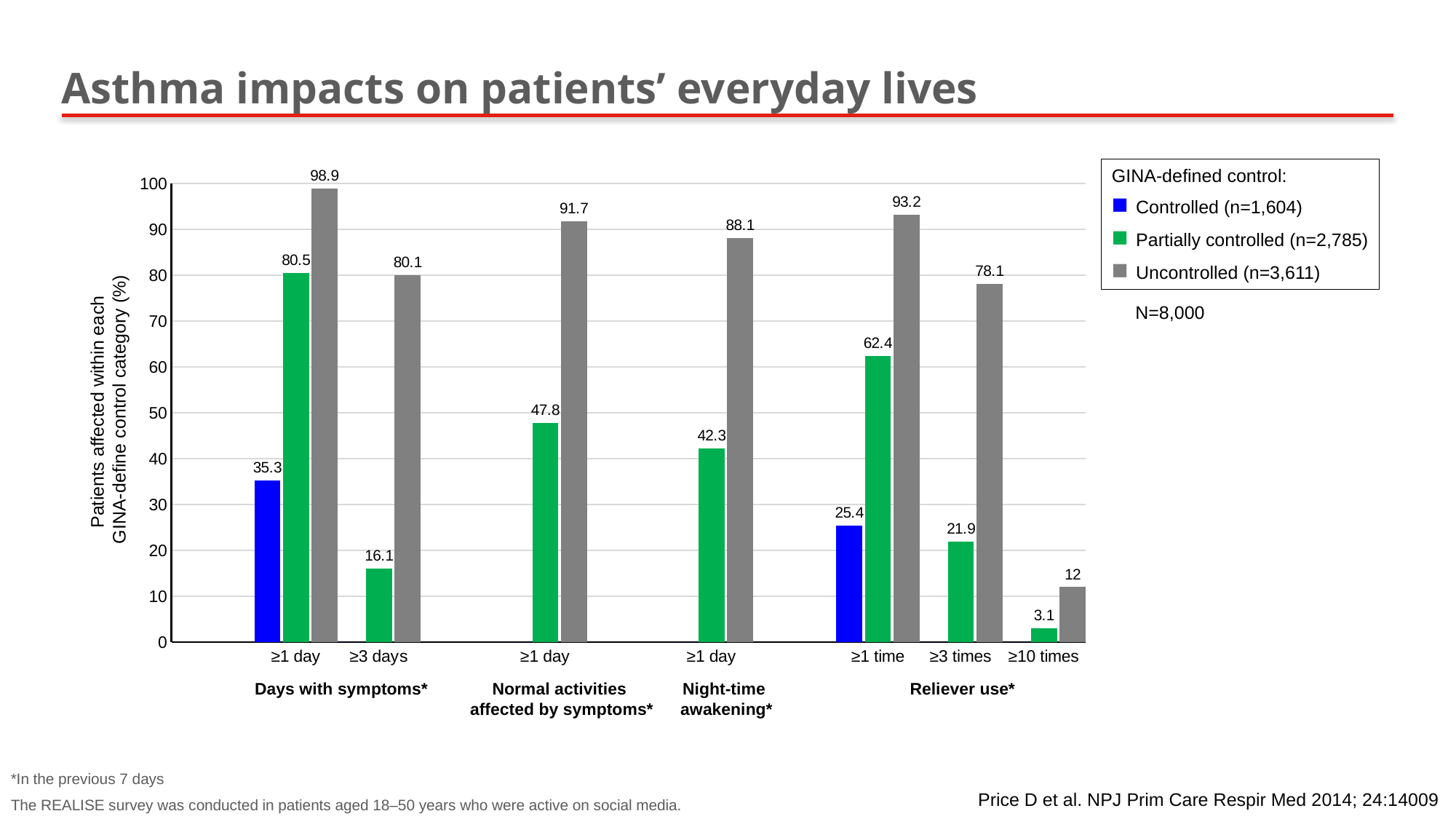
What is the value for Partially controlled patients with ≥1 time of reliever use? 62.4 Which category has the highest value for the Uncontrolled series? ≥1 day (Days with symptoms) What is the value for Uncontrolled patients with ≥1 day of symptoms (Days with symptoms)? 98.9 Which category has the lowest value for the Partially controlled series? ≥10 times (Reliever use) How many series does the legend list? 3 How many categories are shown along the x axis? 7 What is the total N stated next to the legend? N=8,000 What is the difference between the Uncontrolled and Partially controlled values for ≥1 day of night-time awakening? 45.8 What is the value for Controlled patients with ≥1 day of symptoms (Days with symptoms)? 35.3 What is the value for Partially controlled patients with ≥10 times of reliever use? 3.1 What kind of chart is shown on the slide? Bar chart Which is larger: the Uncontrolled value for ≥3 days with symptoms or the Uncontrolled value for ≥3 times of reliever use? ≥3 days with symptoms